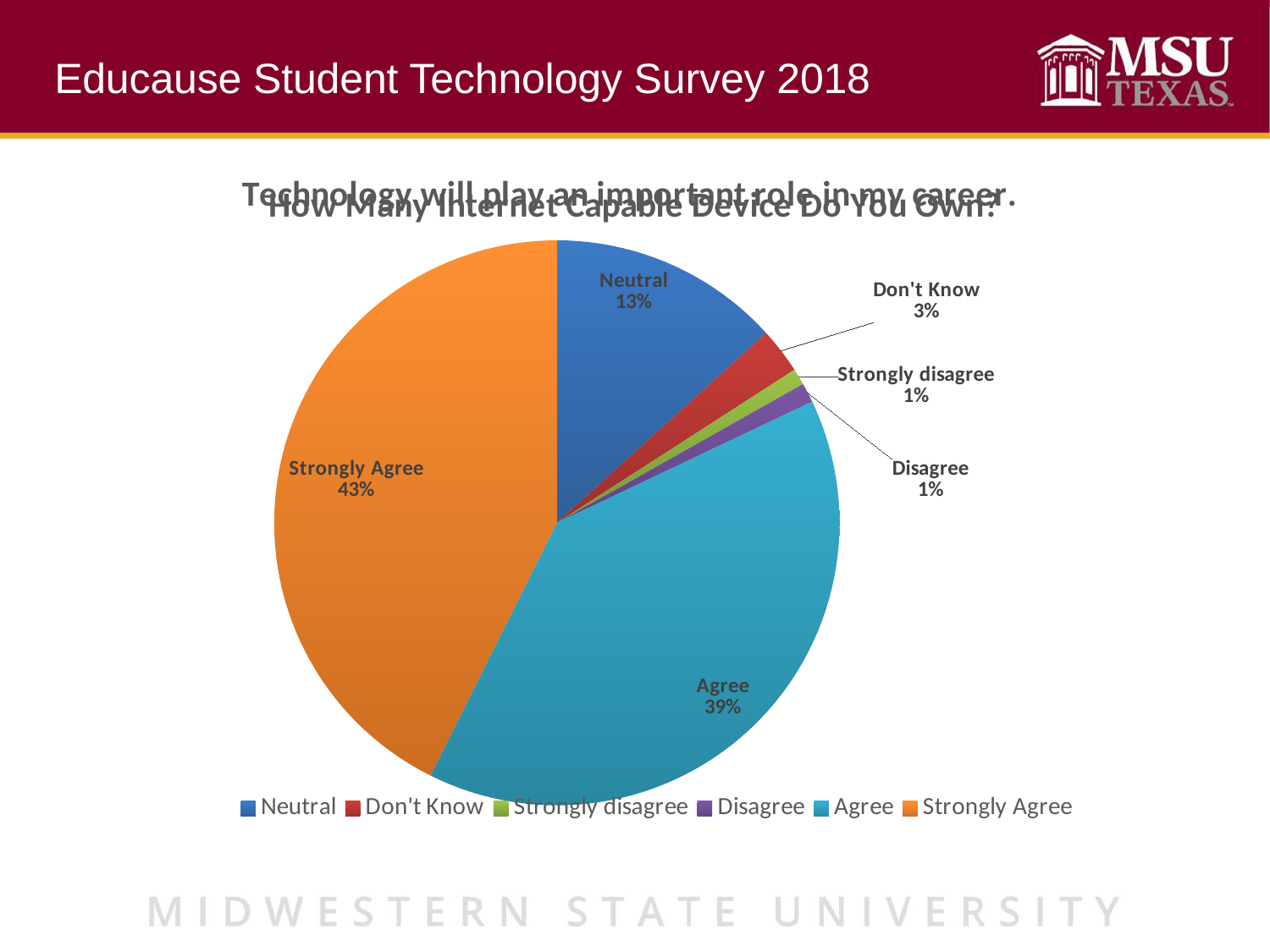
What kind of chart is shown on the slide? Pie chart Which slice is larger, Neutral or Don't Know? Neutral What percentage of the pie chart is labelled Strongly disagree? 1% What is the difference in percentage points between the Strongly Agree and Agree slices? 4 What percentage of the pie chart is labelled Neutral? 13% How many slices does the pie chart have? 6 Which category has the largest slice of the pie chart? Strongly Agree What percentage of the pie chart is labelled Strongly Agree? 43% What percentage of the pie chart is labelled Agree? 39% What is the combined share of the Agree and Strongly Agree slices? 82% What percentage of the pie chart is labelled Don't Know? 3% What colour is the Strongly Agree slice in the pie chart? Orange